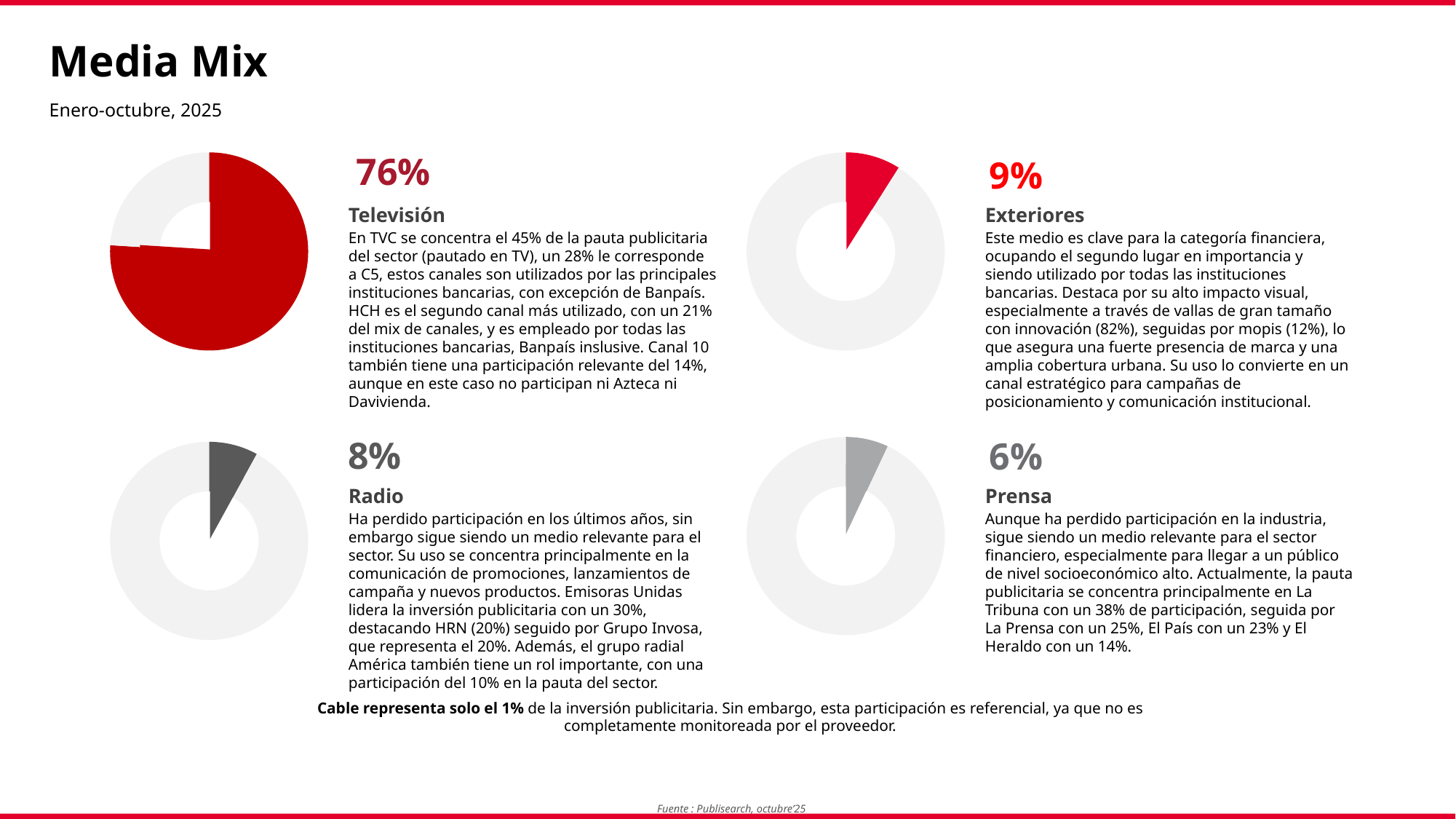
How many donut charts are shown on the slide? 4 Which medium has the smallest share among the four donut charts on the slide? Prensa What is the difference in percentage points between the Radio share and the Prensa share? 2 What share of the media mix does the Exteriores donut chart show? 9% What share of the media mix does the Prensa donut chart show? 6% What colour is the highlighted slice in the Televisión donut chart? Red What is the difference in percentage points between the Televisión share and the Exteriores share? 67 What type of chart is used to show each medium's share on the slide? Donut (pie) chart What share of the media mix does the Radio donut chart show? 8% Which medium has the largest share among the four donut charts on the slide? Televisión Which has a larger share, Exteriores or Radio? Exteriores What share of the media mix does the Televisión donut chart show? 76%